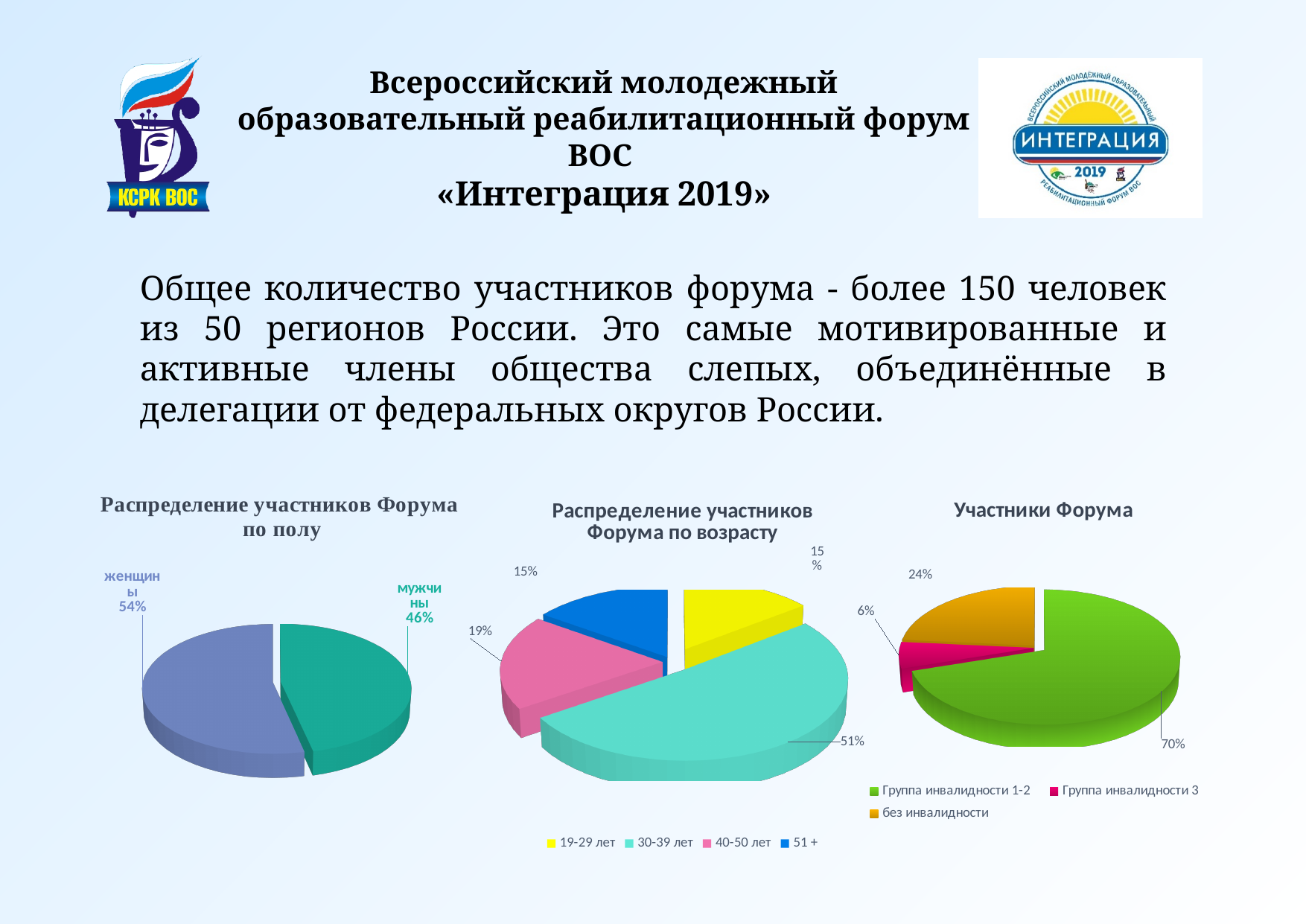
In the chart 'Участники Форума', which category has the smallest share? Группа инвалидности 3 In the chart 'Распределение участников Форума по возрасту', what is the difference in percentage points between the 30-39 лет and 40-50 лет groups? 32 In the chart 'Распределение участников Форума по полу', what share of participants are мужчины? 46% In the chart 'Распределение участников Форума по полу', which group is larger, женщины or мужчины? женщины In the chart 'Распределение участников Форума по возрасту', how many age groups does the legend list? 4 In the chart 'Участники Форума', what share of participants belong to Группа инвалидности 1-2? 70% In the chart 'Распределение участников Форума по возрасту', what share of participants are aged 40-50 лет? 19% What type of chart is 'Участники Форума'? Pie chart In the chart 'Участники Форума', what share of participants are без инвалидности? 24% In the chart 'Распределение участников Форума по полу', what share of participants are женщины? 54% In the chart 'Распределение участников Форума по возрасту', what share of participants are aged 30-39 лет? 51% In the chart 'Распределение участников Форума по возрасту', which age group has the largest share? 30-39 лет